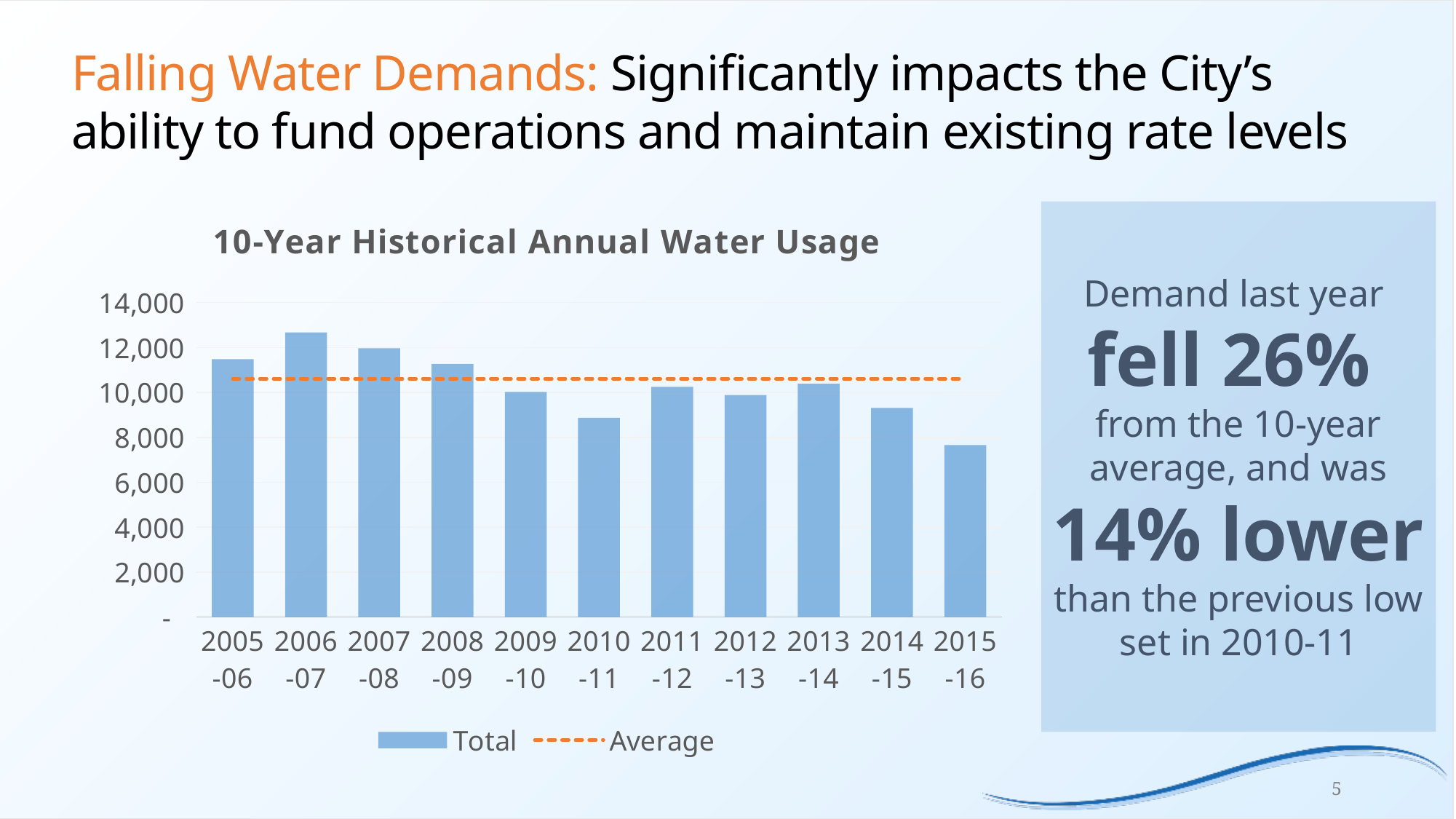
Which is larger, the water usage in 2009-10 or in 2010-11? 2009-10 How many fiscal years are plotted as bars in the chart? 11 Overall, do the annual water usage values rise or fall from 2005-06 to 2015-16? fall What kind of chart is shown on the slide? bar chart Which fiscal year has the highest annual water usage? 2006-07 What is the title of the chart? 10-Year Historical Annual Water Usage What does the orange dashed line in the chart represent? Average Is the value for 2006-07 greater or less than 12,000? greater Is the value for 2010-11 greater or less than 10,000? less Which fiscal year has the lowest annual water usage? 2015-16 Is the value for 2015-16 greater or less than 8,000? less How many series does the chart legend list? 2